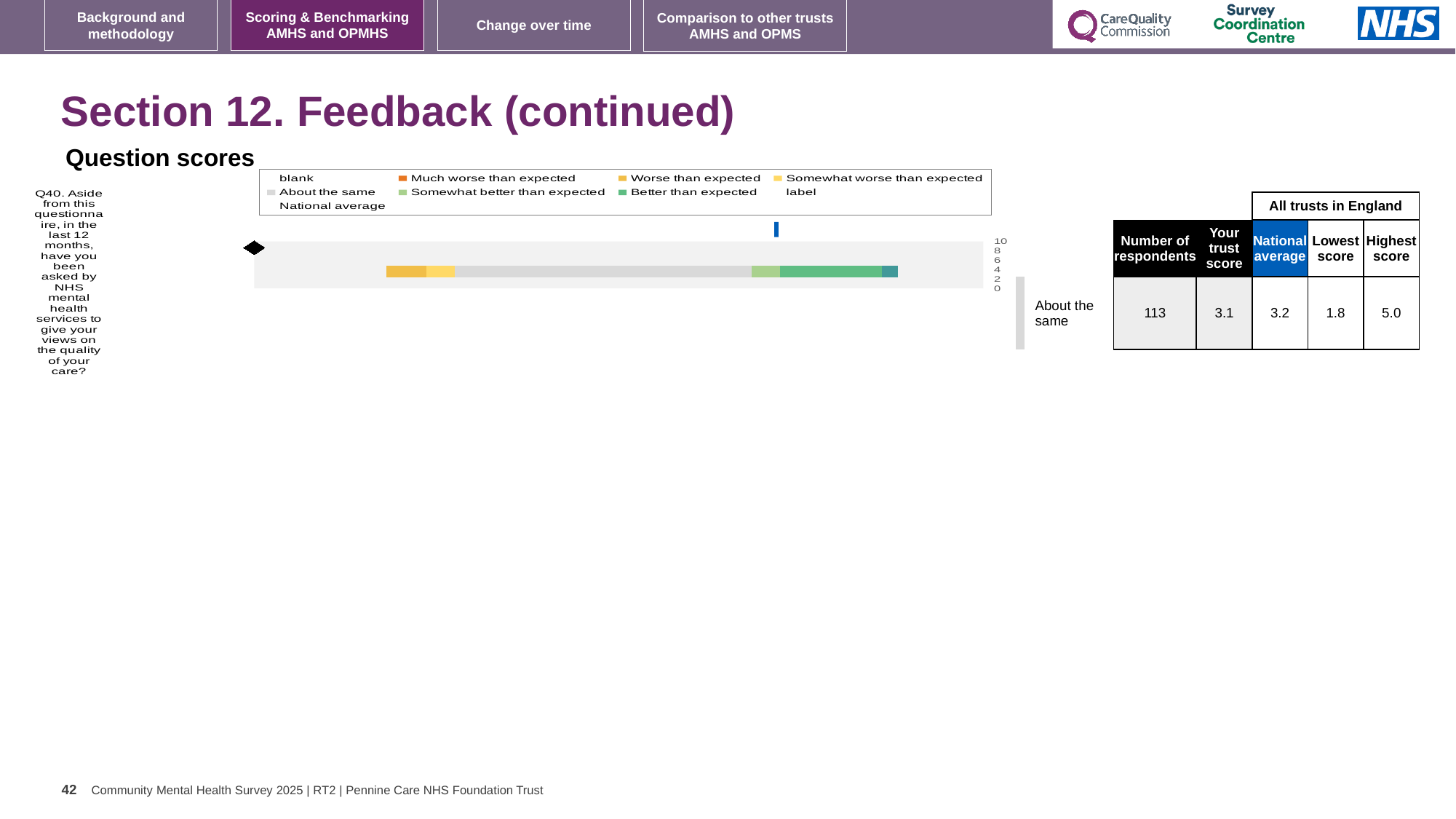
How many survey questions are plotted in the Question scores chart? 1 For Q40, what is the difference between the highest and lowest scores among all trusts in England? 3.2 For Q40, which is larger: the trust's score or the national average? National average What is the national average for Q40 shown in the table beside the chart? 3.2 What is the lowest score among all trusts in England for Q40? 1.8 What benchmark category is the trust's Q40 score labelled as next to the chart? About the same Which legend entry is shown in orange in the Question scores chart? Much worse than expected Which question is plotted in the Question scores chart? Q40 What is the highest score among all trusts in England for Q40? 5.0 What kind of chart is used to show the Q40 question score? bar chart What is the number of respondents for Q40 shown in the table beside the chart? 113 What is the trust's score for Q40 shown in the table beside the chart? 3.1